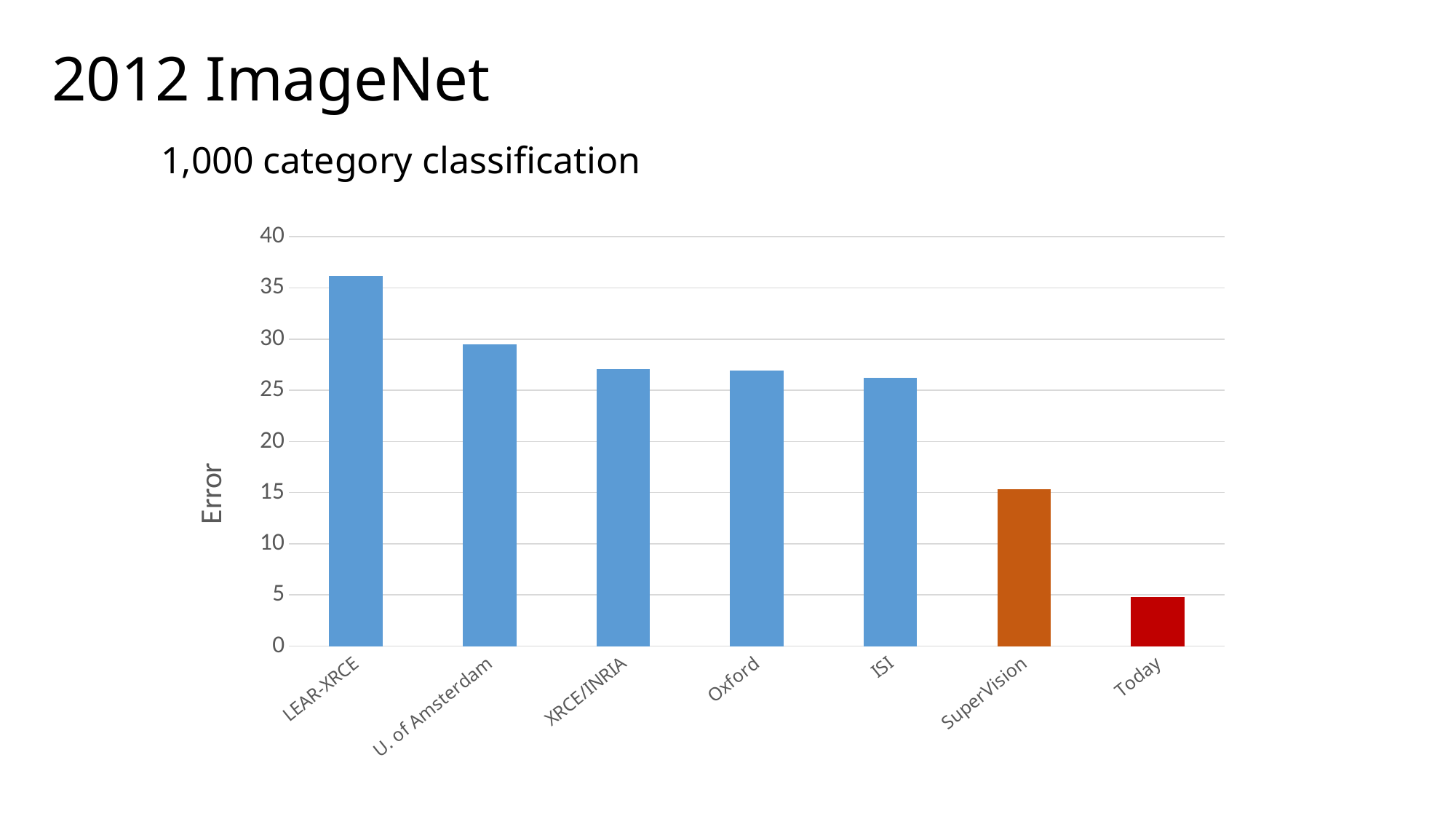
What is the label on the vertical axis of the chart? Error Which category has the highest error in the chart? LEAR-XRCE Is the error for LEAR-XRCE greater or less than 30? greater Is the error for Oxford greater or less than 30? less Is the error for SuperVision greater or less than 20? less What kind of chart is shown on the slide? bar chart How many categories are plotted on the x axis of the chart? 7 Which has a higher error, ISI or SuperVision? ISI Which category has the lowest error in the chart? Today Do the error values generally rise or fall moving from left to right along the x axis? fall